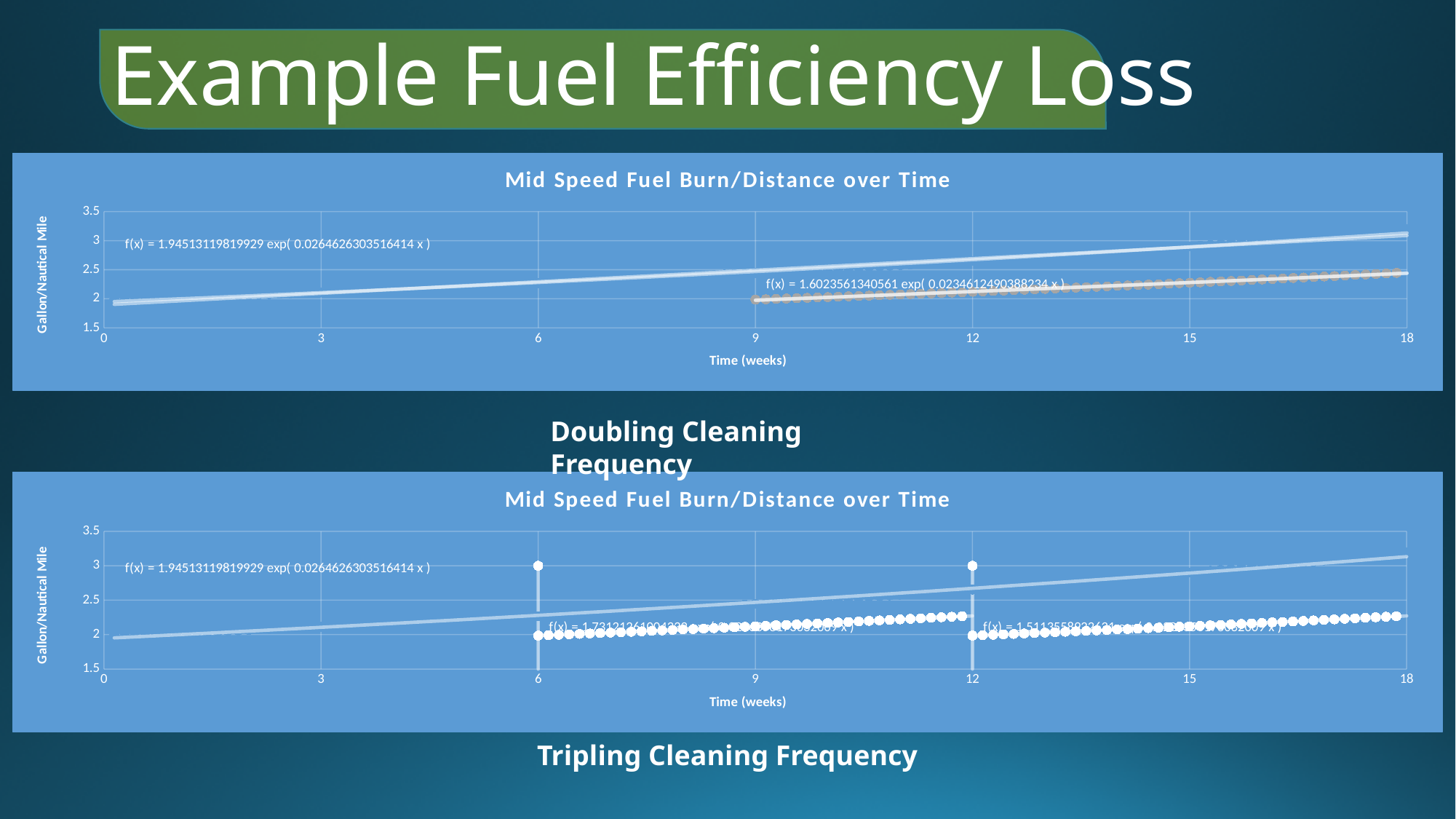
In the top chart, at which week does the lower dotted series begin? 9 In the bottom chart, is the value of the dotted series just after week 6 greater or less than 2.5? less In the top chart, is the value of the lower dotted series at week 18 greater or less than 3? less What is the title of the top chart? Mid Speed Fuel Burn/Distance over Time In the bottom chart, is the value of the upper line at week 18 greater or less than 2.5? greater In the top chart, what is the highest value shown on the y axis? 3.5 In the top chart, do the plotted values rise or fall as time increases? rise In the bottom chart (Tripling Cleaning Frequency), at which weeks does the dotted series drop back down? 6 and 12 In the top chart, what is the exponent coefficient in the trendline equation f(x) = 1.94513119819929 exp( ... x )? 0.0264626303516414 In the top chart, at week 18, which is larger: the upper line or the lower dotted series? the upper line In the top chart, what is the label of the x axis? Time (weeks)